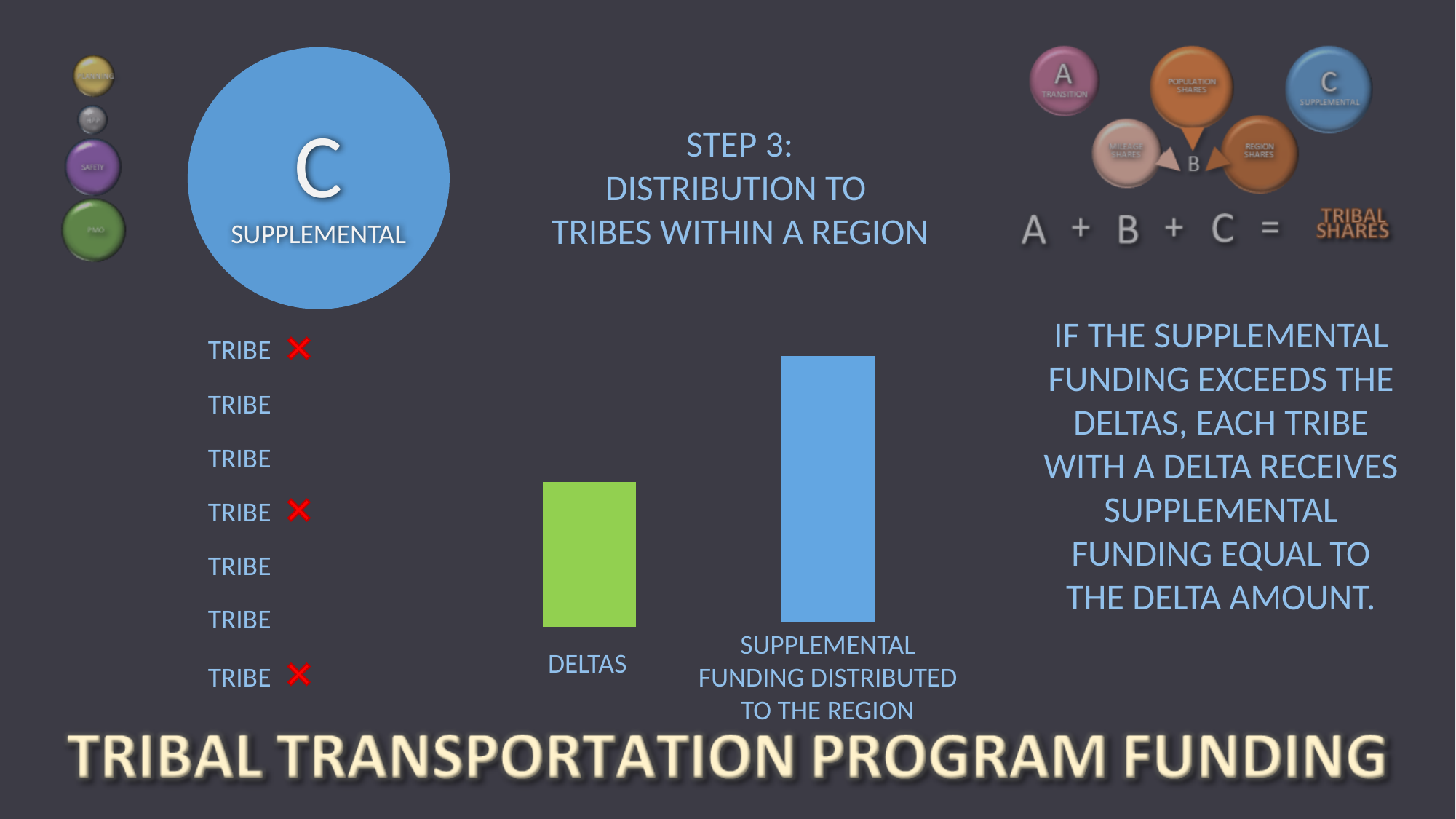
Is the DELTAS bar shorter or taller than the SUPPLEMENTAL FUNDING DISTRIBUTED TO THE REGION bar? Shorter Which category has the highest bar in the chart? SUPPLEMENTAL FUNDING DISTRIBUTED TO THE REGION What colour is the DELTAS bar? Green What kind of chart is shown in the middle of the slide? Bar chart How many bars does the chart show? 2 What colour is the SUPPLEMENTAL FUNDING DISTRIBUTED TO THE REGION bar? Blue Which category has the lowest bar in the chart? DELTAS Which bar is taller, DELTAS or SUPPLEMENTAL FUNDING DISTRIBUTED TO THE REGION? SUPPLEMENTAL FUNDING DISTRIBUTED TO THE REGION